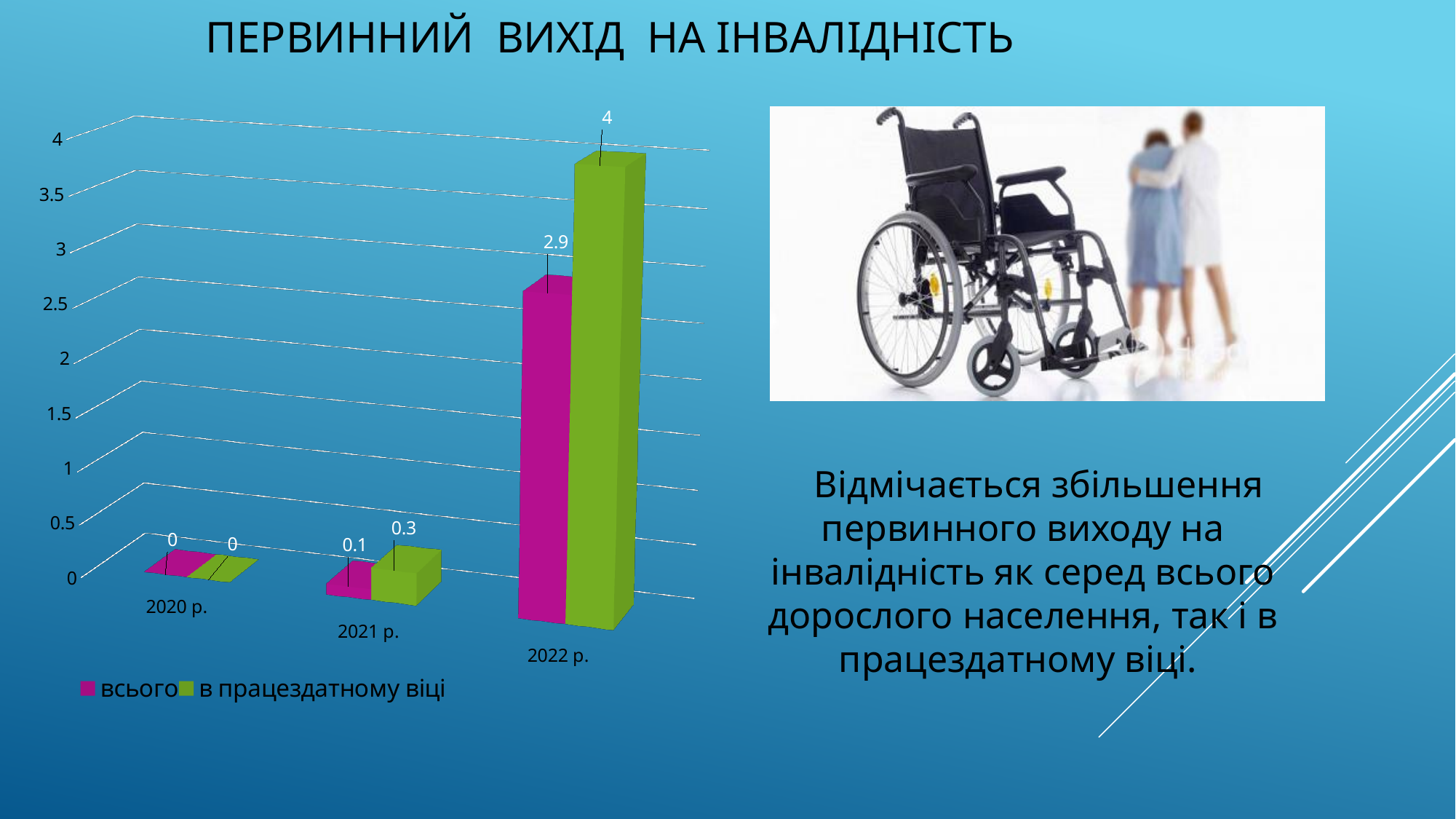
Which year has the highest value for "в працездатному віці"? 2022 р. What is the value for "всього" in 2022 р.? 2.9 How many years are shown on the x axis of the chart? 3 How many series does the chart legend list? 2 In 2021 р., which is larger: "всього" or "в працездатному віці"? в працездатному віці What kind of chart is shown on the slide? bar chart What is the difference between the "в працездатному віці" and "всього" values in 2022 р.? 1.1 What is the value for "всього" in 2021 р.? 0.1 What is the value for "всього" in 2020 р.? 0 What is the value for "в працездатному віці" in 2021 р.? 0.3 What is the value for "в працездатному віці" in 2022 р.? 4 Do the values for "всього" rise or fall from 2020 р. to 2022 р.? rise